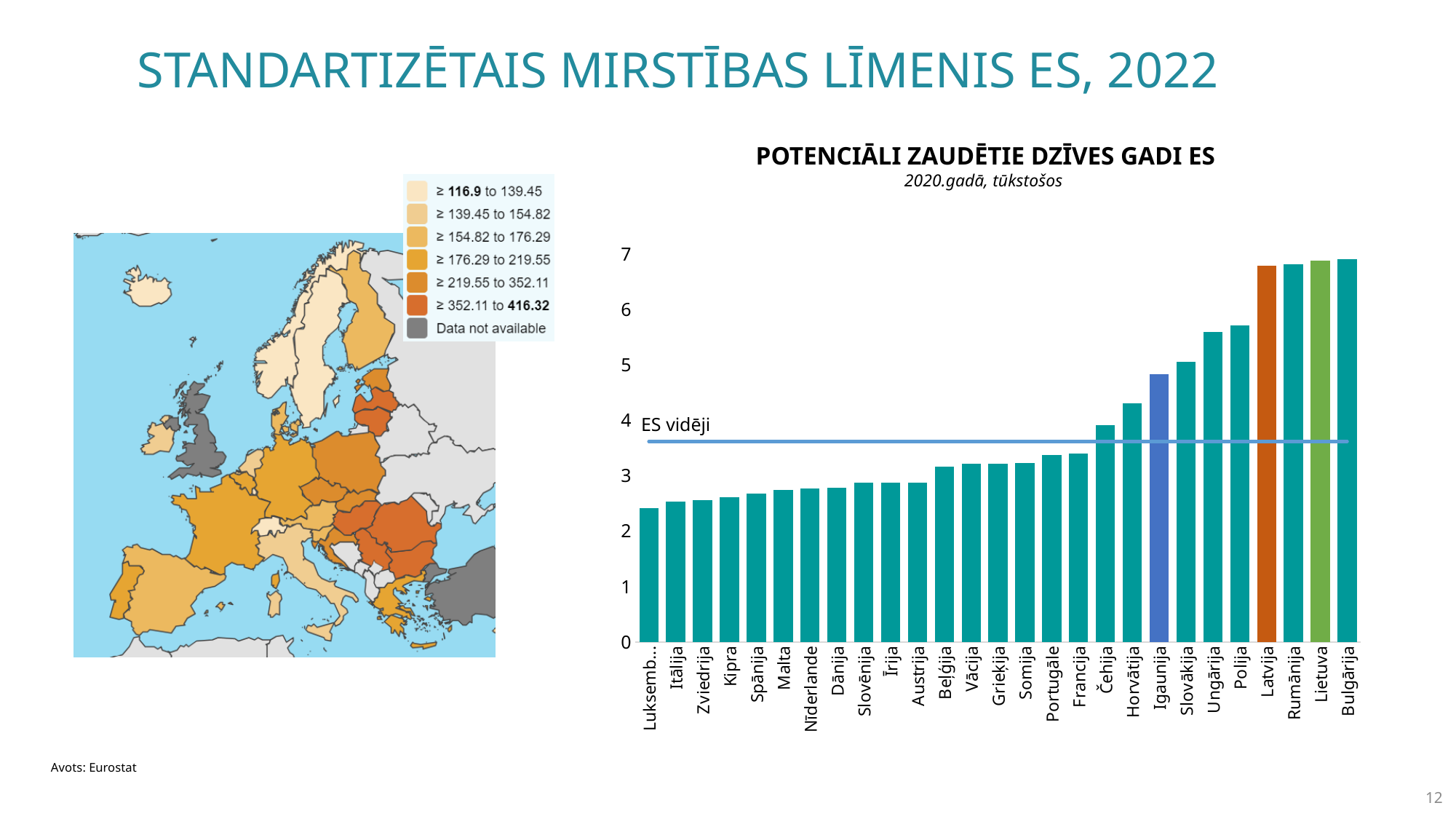
In the bar chart 'POTENCIĀLI ZAUDĒTIE DZĪVES GADI ES', which has the larger value, Čehija or Horvātija? Horvātija In the bar chart 'POTENCIĀLI ZAUDĒTIE DZĪVES GADI ES', which has the larger value, Latvija or Igaunija? Latvija In the bar chart 'POTENCIĀLI ZAUDĒTIE DZĪVES GADI ES', is the value for Ungārija greater or less than 5? greater In the bar chart 'POTENCIĀLI ZAUDĒTIE DZĪVES GADI ES', is the value for Latvija greater or less than 6? greater In the bar chart 'POTENCIĀLI ZAUDĒTIE DZĪVES GADI ES', is the value for Čehija greater or less than 3? greater In the bar chart 'POTENCIĀLI ZAUDĒTIE DZĪVES GADI ES', do the values rise or fall from left to right along the x axis? rise In the bar chart 'POTENCIĀLI ZAUDĒTIE DZĪVES GADI ES', how many countries are plotted? 27 In the bar chart 'POTENCIĀLI ZAUDĒTIE DZĪVES GADI ES', what is the label of the horizontal line drawn across the bars? ES vidēji What kind of chart is the chart titled 'POTENCIĀLI ZAUDĒTIE DZĪVES GADI ES'? bar chart In the map legend on the left of the slide, what is the upper bound of the highest colour range? 416.32